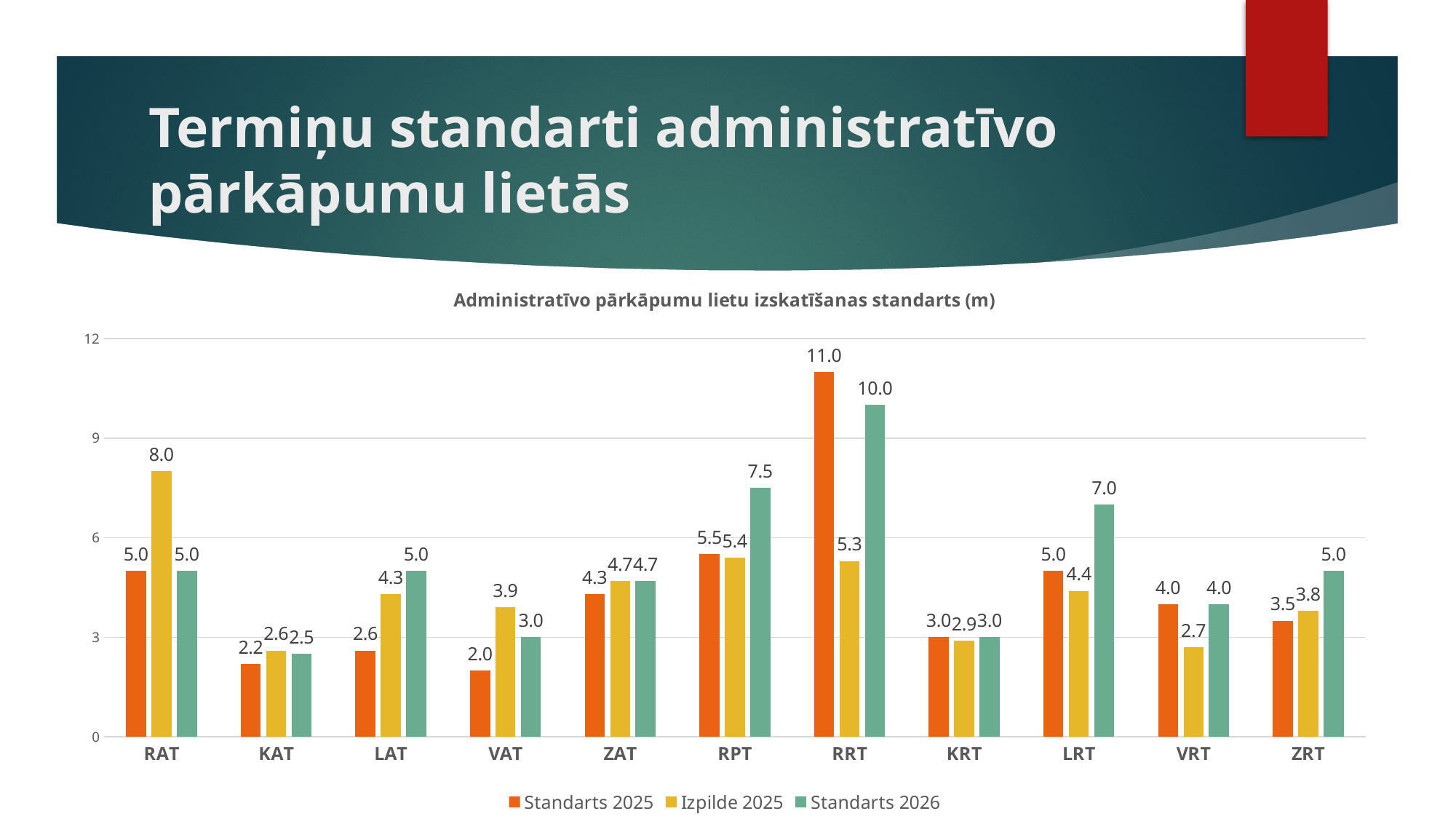
What is the Standarts 2025 value for VAT? 2.0 What is the difference between the Standarts 2025 and Standarts 2026 values for RRT? 1.0 What is the Standarts 2026 value for RPT? 7.5 What is the title of the chart? Administratīvo pārkāpumu lietu izskatīšanas standarts (m) Is the Standarts 2026 value for LRT greater or less than 6? greater How many series does the legend list? 3 What is the Izpilde 2025 value for RAT? 8.0 How many categories are shown on the x axis? 11 What kind of chart is shown on the slide? Bar chart Which is larger for LRT: the Izpilde 2025 value or the Standarts 2026 value? Standarts 2026 Which category has the highest Standarts 2025 value? RRT Which category has the lowest Standarts 2025 value? VAT